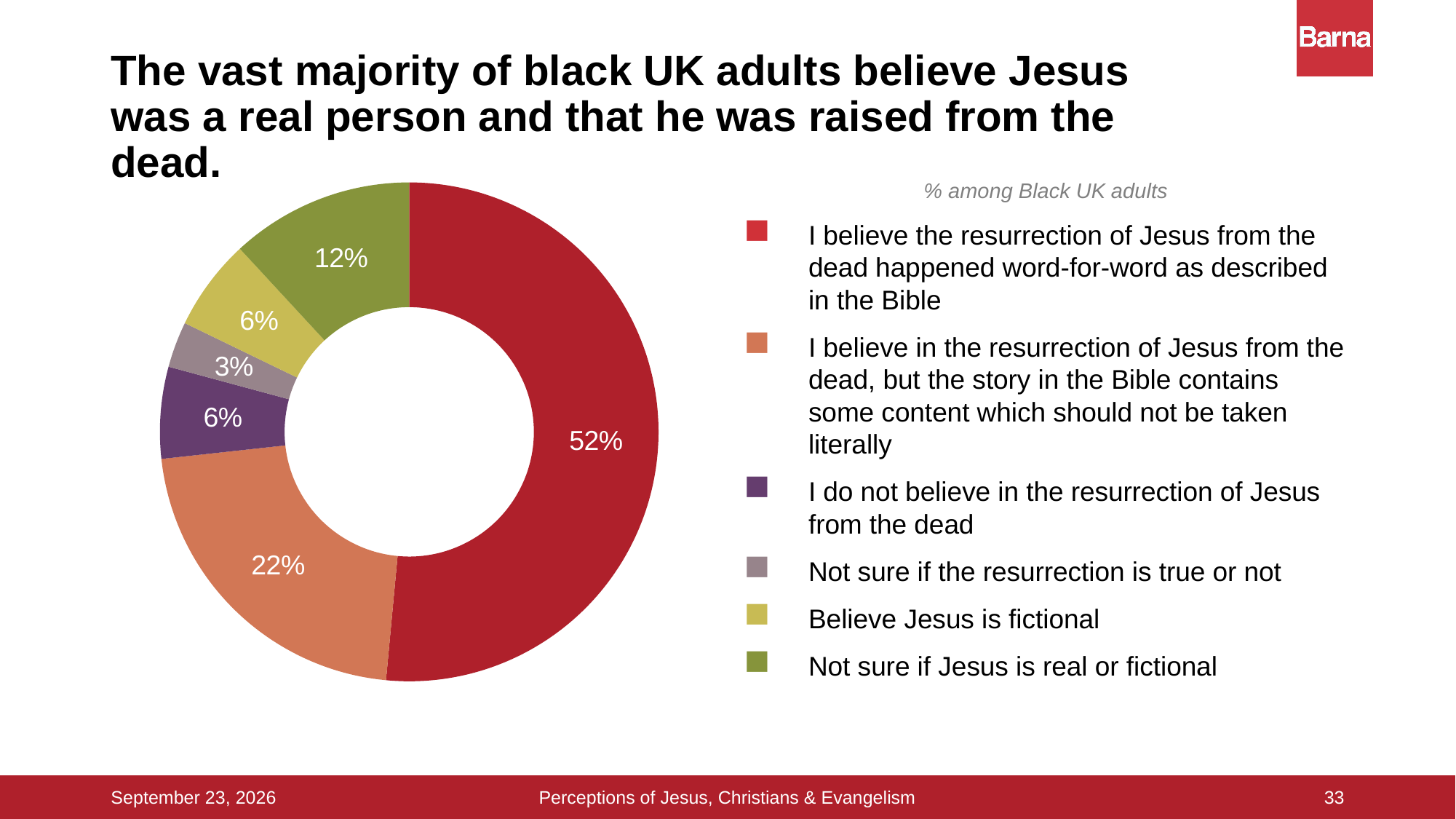
What percentage of Black UK adults believe in the resurrection but think the Bible story contains some content which should not be taken literally? 22% What kind of chart is shown on the slide? Pie chart (donut) What colour represents the response 'I do not believe in the resurrection of Jesus from the dead'? Purple Which is larger: the share who are not sure if Jesus is real or fictional, or the share who believe Jesus is fictional? Not sure if Jesus is real or fictional Which response has the largest share of the chart? I believe the resurrection of Jesus from the dead happened word-for-word as described in the Bible What percentage of Black UK adults are not sure if Jesus is real or fictional? 12% What is the difference in percentage points between those who believe the resurrection happened word-for-word and those who believe it but think some content should not be taken literally? 30 What percentage of Black UK adults believe the resurrection of Jesus from the dead happened word-for-word as described in the Bible? 52% How many response categories are shown in the chart? 6 What percentage of Black UK adults are not sure if the resurrection is true or not? 3% What percentage of Black UK adults believe Jesus is fictional? 6% Which response has the smallest share of the chart? Not sure if the resurrection is true or not